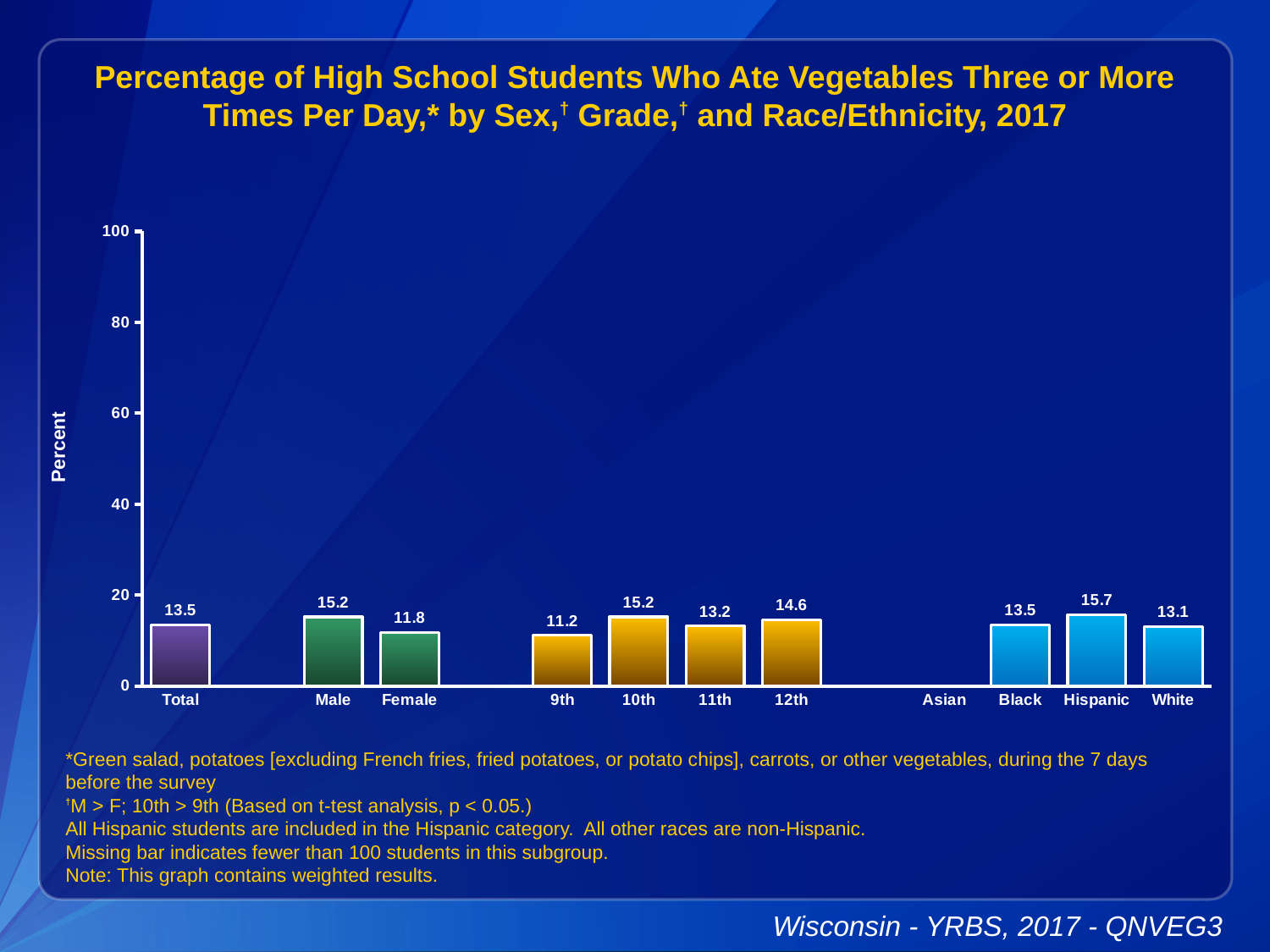
What is the value for 9th grade? 11.2 Which category has the highest value on the chart? Hispanic What kind of chart is shown on the slide? bar chart Which category on the x axis has no bar shown? Asian How many categories on the x axis have a bar shown? 10 Which category has the lowest value among those with a bar shown? 9th What is the value for Total? 13.5 What is the difference between the values for Male and Female? 3.4 Is the value for 12th grade greater or less than 20? less Which is larger, the value for 10th grade or 11th grade? 10th What is the value for Hispanic students? 15.7 What is the value for Female? 11.8